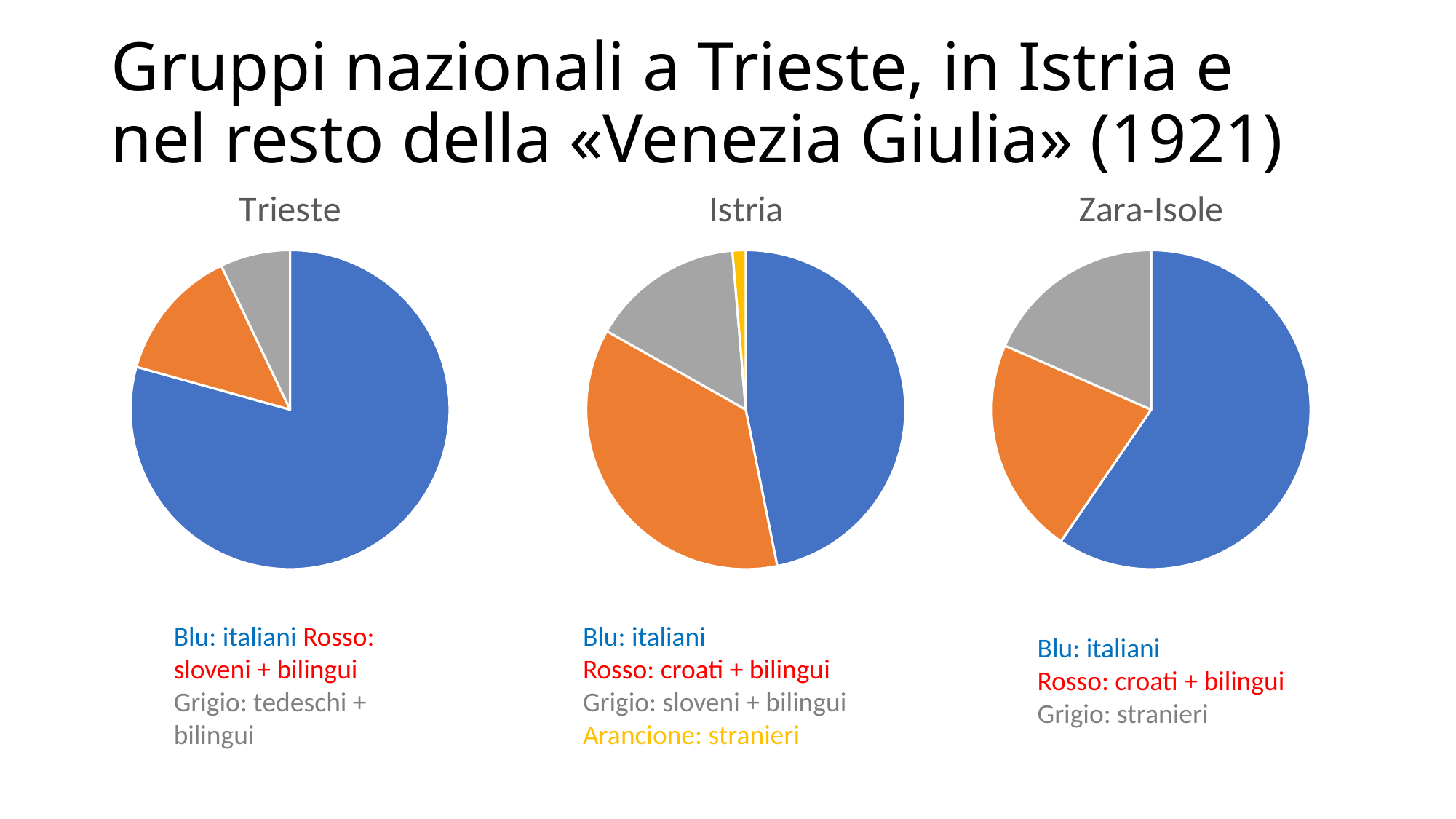
In the Istria chart, which colour represents stranieri? Arancione (orange/yellow) What kind of chart is used for Trieste? pie chart How many slices does the Zara-Isole pie chart have? 3 In the Istria chart, which slice is larger: croati + bilingui or sloveni + bilingui? croati + bilingui In the Trieste chart, which slice is larger: sloveni + bilingui or tedeschi + bilingui? sloveni + bilingui In the Zara-Isole chart, which group has the largest slice? italiani In the Istria chart, which group has the smallest slice? stranieri How many slices does the Istria pie chart have? 4 How many slices does the Trieste pie chart have? 3 In the Trieste chart, which group has the largest slice? italiani In the Istria chart, which group has the largest slice? italiani In the Trieste chart, which group has the smallest slice? tedeschi + bilingui